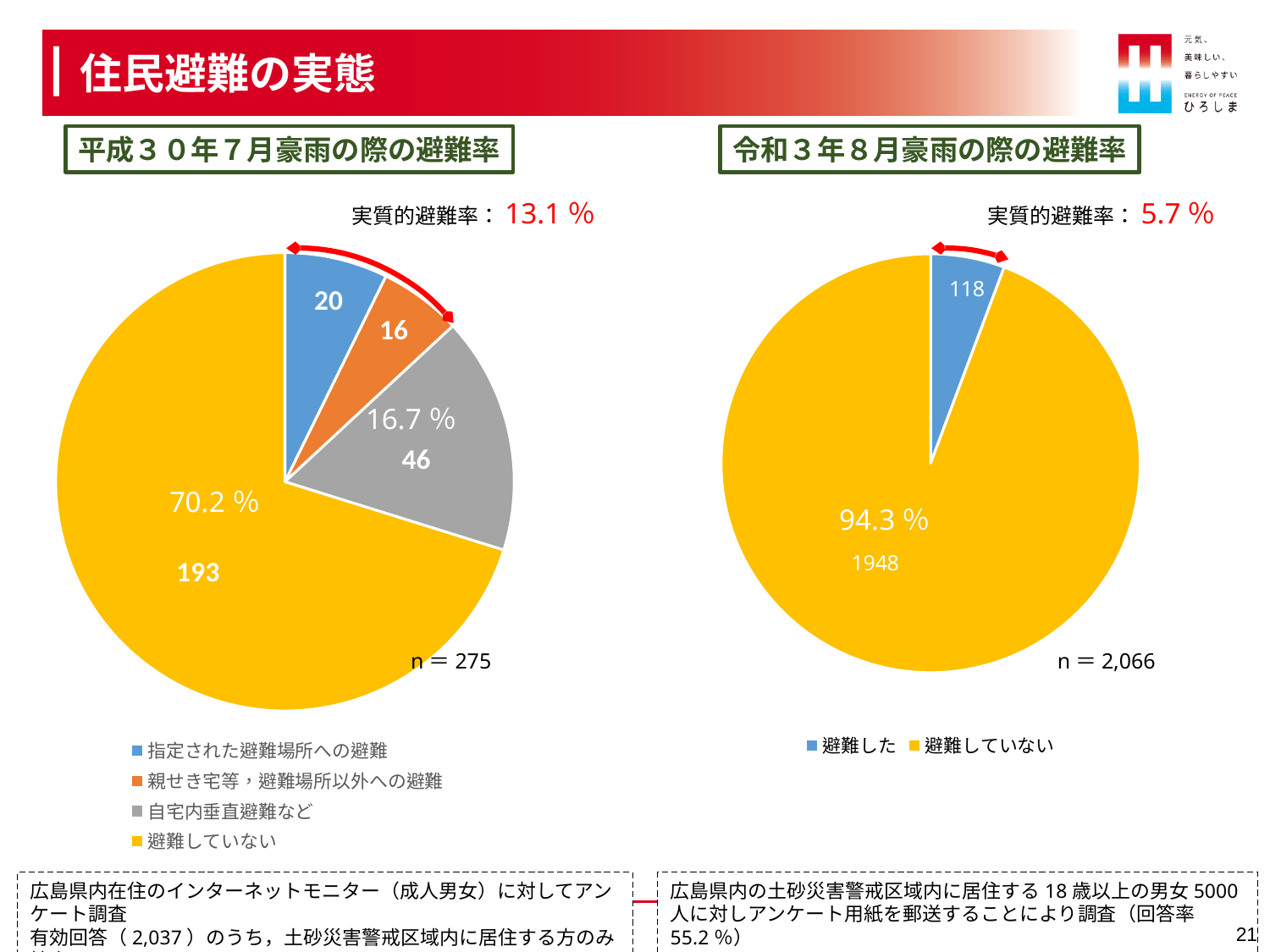
In the left pie chart (平成30年7月豪雨の際の避難率), what is the value for 自宅内垂直避難など? 46 In the right pie chart (令和3年8月豪雨の際の避難率), what is the value for 避難していない? 1948 In the left pie chart (平成30年7月豪雨の際の避難率), what is the value for 避難していない? 193 In the left pie chart (平成30年7月豪雨の際の避難率), what is the value for 指定された避難場所への避難? 20 In the left pie chart (平成30年7月豪雨の際の避難率), what percentage share is shown for 避難していない? 70.2 % In the right pie chart (令和3年8月豪雨の際の避難率), what is the value for 避難した? 118 How many categories does the legend of the left pie chart (平成30年7月豪雨の際の避難率) list? 4 In the left pie chart (平成30年7月豪雨の際の避難率), what is the difference between 自宅内垂直避難など and 指定された避難場所への避難? 26 In the right pie chart (令和3年8月豪雨の際の避難率), what percentage share is shown for 避難していない? 94.3 % What kind of chart is used on the left side of the slide (平成30年7月豪雨の際の避難率)? pie chart In the left pie chart (平成30年7月豪雨の際の避難率), which category has the smallest value? 親せき宅等，避難場所以外への避難 What is the sample size (n) shown for the right pie chart (令和3年8月豪雨の際の避難率)? 2,066